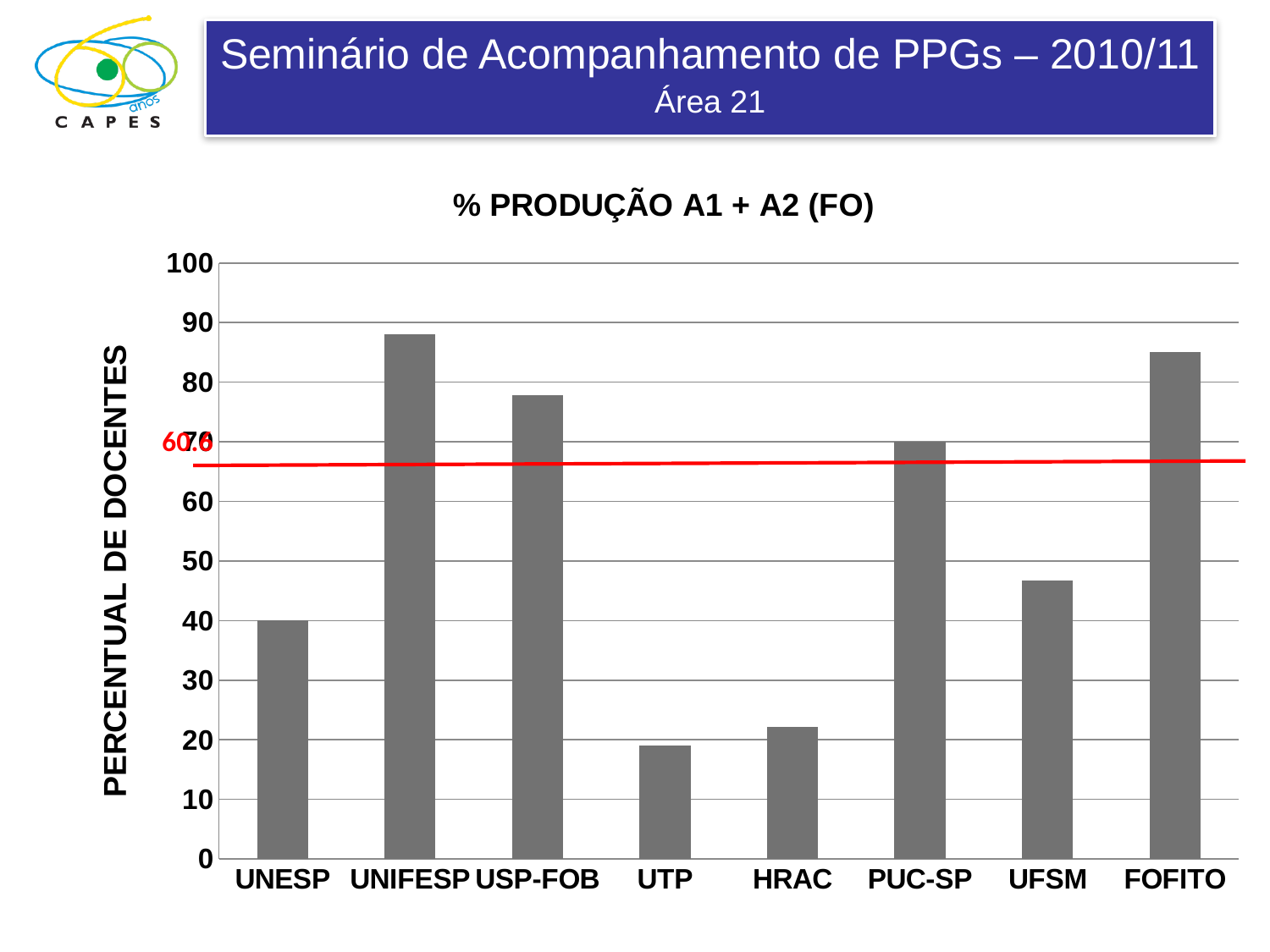
What type of chart is shown on the slide? bar chart Which institution has the highest bar in the chart? UNIFESP What is the label of the y axis of the chart? PERCENTUAL DE DOCENTES Which institution has the lowest bar in the chart? UTP Is the value for UFSM greater or less than 50? less Which has a larger value, USP-FOB or UFSM? USP-FOB How many institutions (categories) are shown on the x axis of the chart? 8 Which has a larger value, UNESP or PUC-SP? PUC-SP Is the value for HRAC greater or less than 30? less Is the value for UNIFESP greater or less than 80? greater What is the title of the chart? % PRODUÇÃO A1 + A2 (FO)